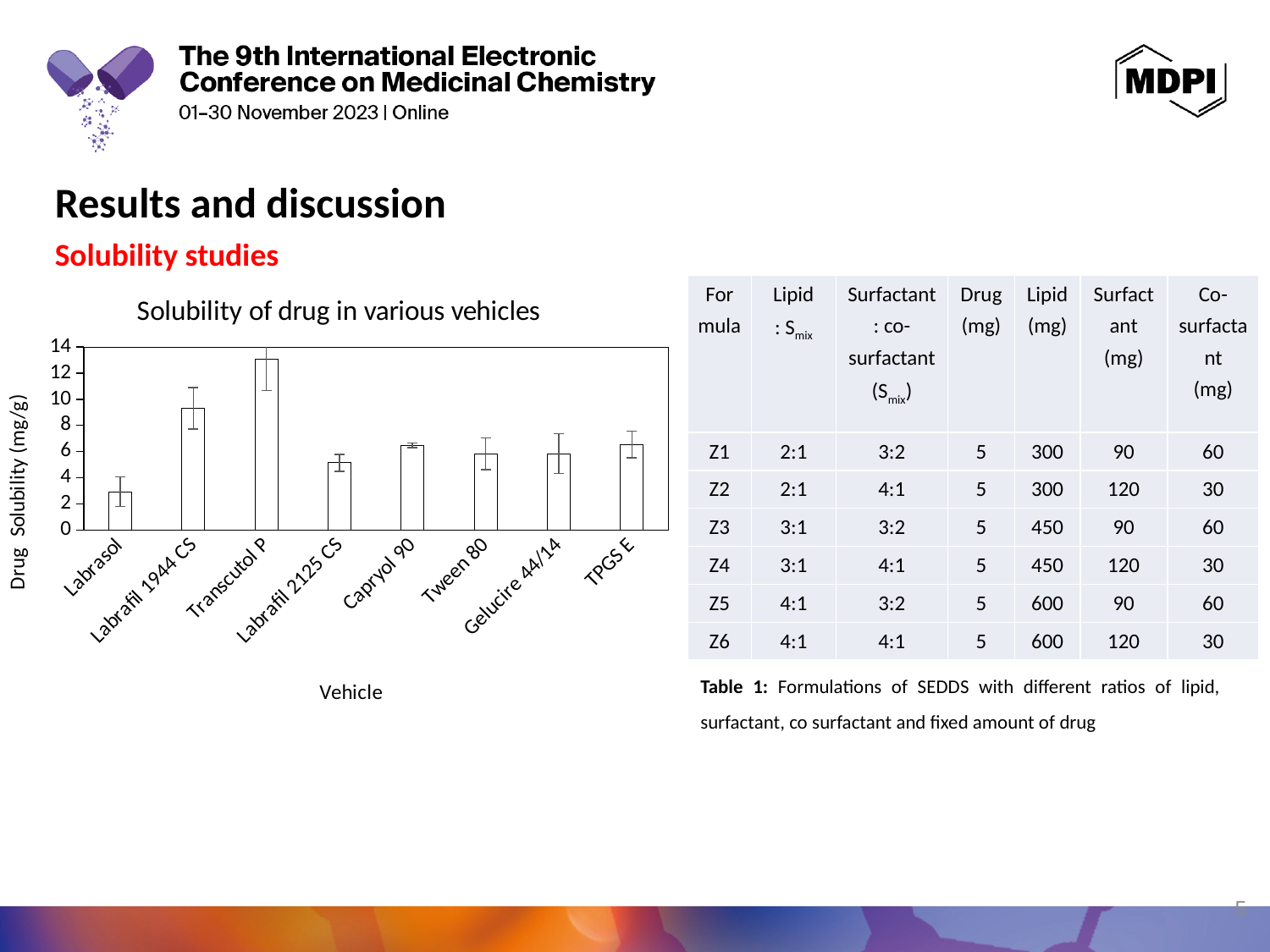
How many vehicles are plotted on the x axis of the solubility chart? 8 Is the drug solubility in Transcutol P greater or less than 12 mg/g? greater What is the title of the chart on the slide? Solubility of drug in various vehicles Which vehicle has a higher drug solubility, Labrasol or Tween 80? Tween 80 Which vehicle has a higher drug solubility, Labrafil 1944 CS or Capryol 90? Labrafil 1944 CS Is the drug solubility in Labrafil 1944 CS greater or less than 8 mg/g? greater What kind of chart is used to show the solubility of drug in various vehicles? Bar chart Which vehicle shows the highest drug solubility? Transcutol P Is the drug solubility in Labrasol greater or less than 4 mg/g? less What is the label of the y axis of the solubility chart? Drug Solubility (mg/g) Which vehicle shows the lowest drug solubility? Labrasol